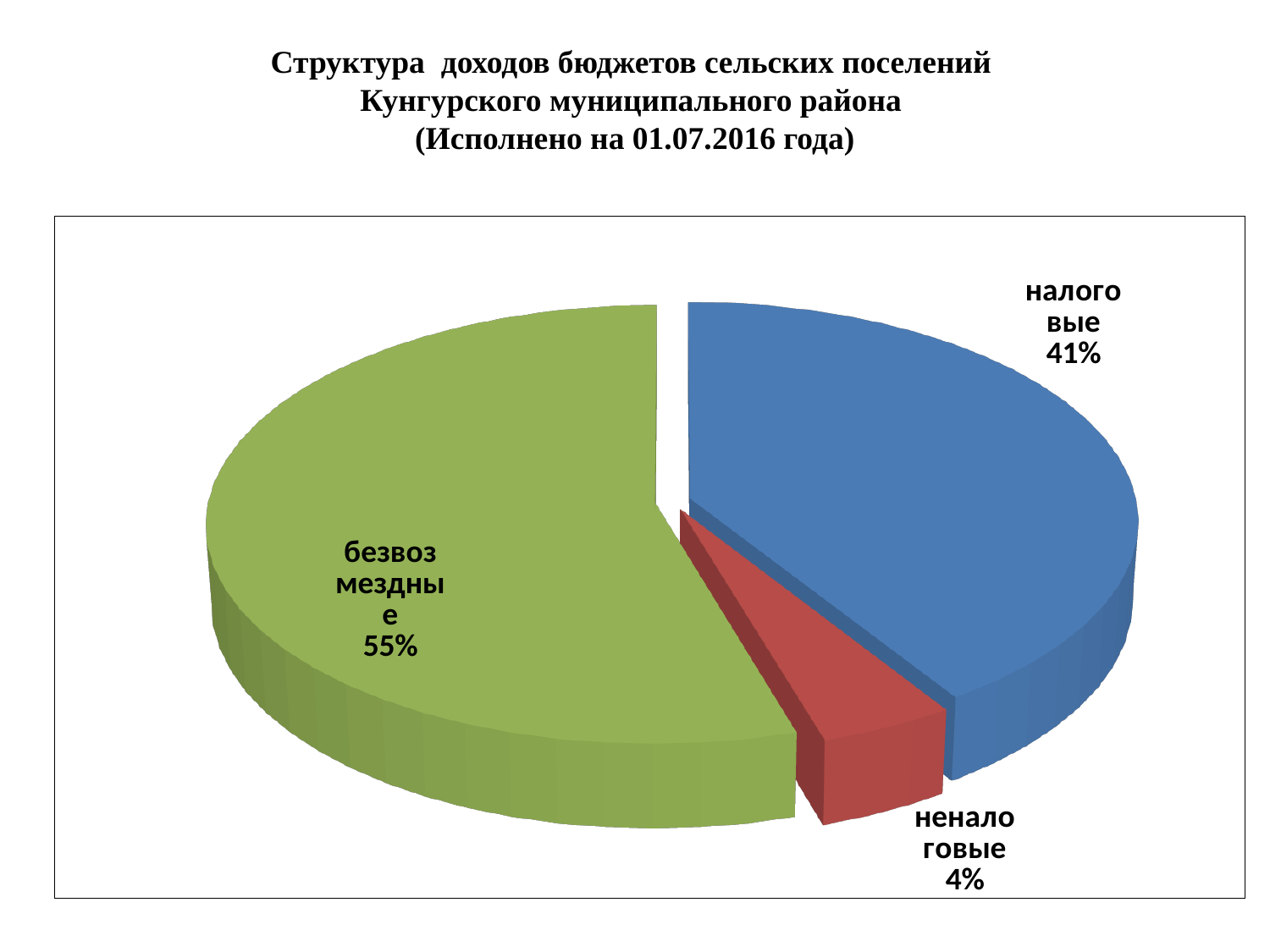
What is the difference in percentage points between the 'налоговые' and 'неналоговые' shares? 37 Which category has the largest share of the pie? безвозмездные What colour is the 'безвозмездные' slice? green What share of the pie does the 'налоговые' slice represent? 41% As of what date is the budget income structure shown, according to the title? 01.07.2016 Which category has the smallest share of the pie? неналоговые What is the difference in percentage points between the 'безвозмездные' and 'налоговые' shares? 14 How many slices does the pie chart have? 3 What share of the pie does the 'безвозмездные' slice represent? 55% What share of the pie does the 'неналоговые' slice represent? 4% Which is larger, the share of 'налоговые' or the share of 'неналоговые'? налоговые What kind of chart is shown on the slide? pie chart